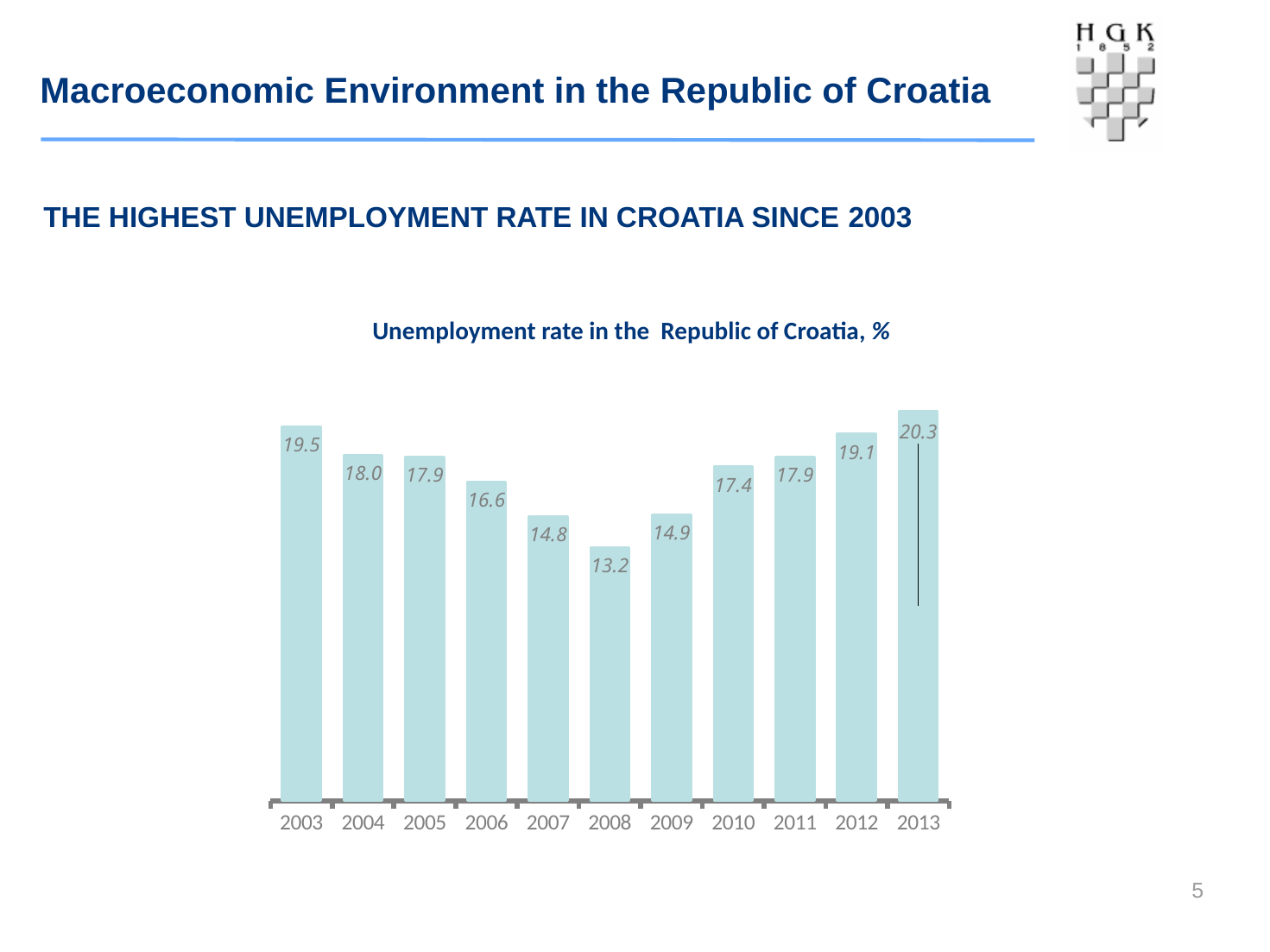
What is the difference between the unemployment rate in 2003 and in 2004? 1.5 Which year has the highest unemployment rate in the chart? 2013 What is the unemployment rate shown for 2013? 20.3 How many years are shown on the x axis of the chart? 11 What is the unemployment rate shown for 2003? 19.5 What is the difference between the unemployment rate in 2013 and in 2008? 7.1 What is the unemployment rate shown for 2008? 13.2 Which year has a higher unemployment rate, 2006 or 2010? 2010 Which year has the lowest unemployment rate in the chart? 2008 What is the title of the chart? Unemployment rate in the Republic of Croatia, % What kind of chart is used to show the unemployment rate? Bar chart Do the unemployment rate values rise or fall from 2008 to 2013? Rise